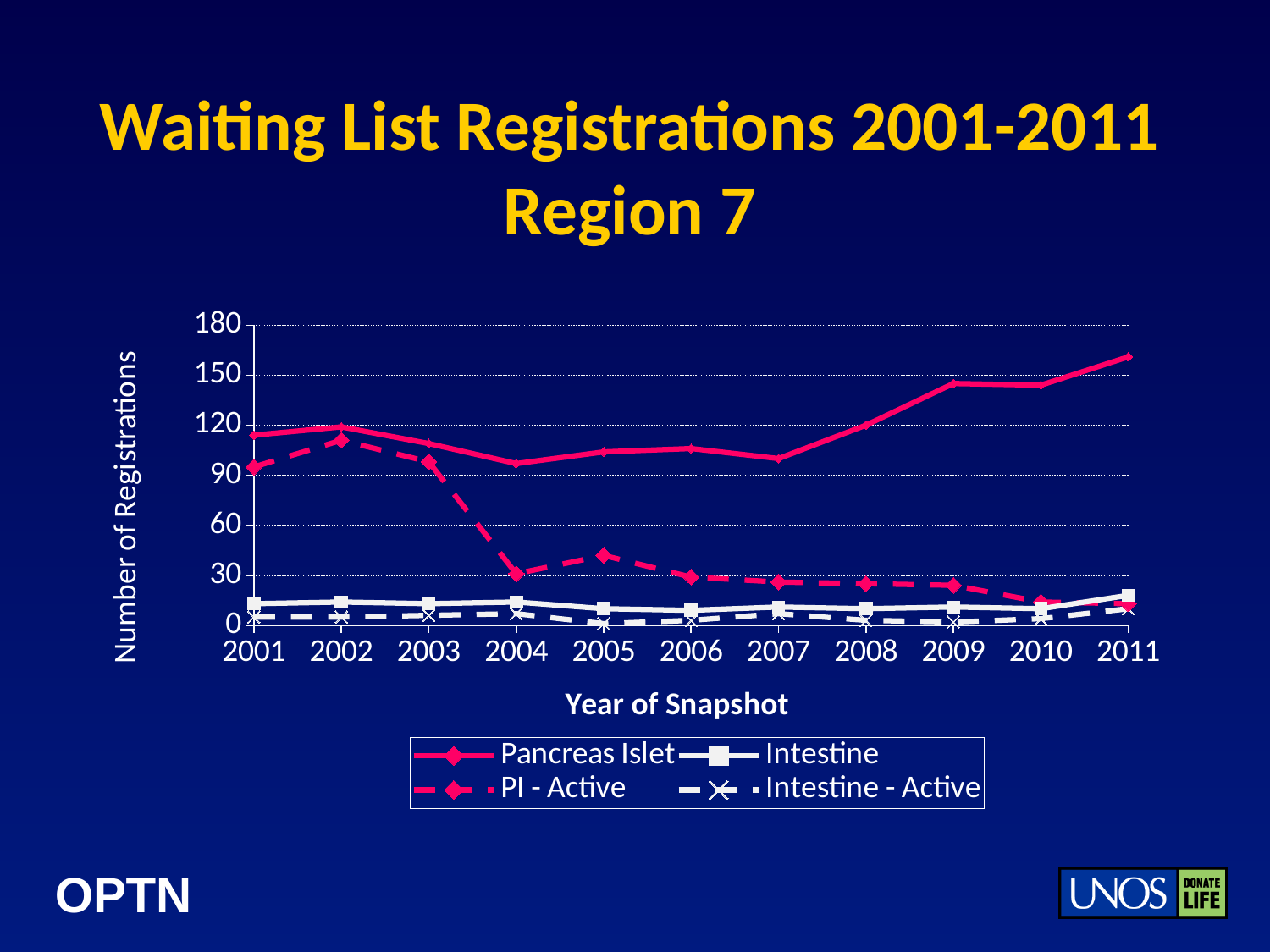
Which is larger in 2004, Pancreas Islet or PI - Active? Pancreas Islet How many years are shown on the x axis? 11 What is the title of the y axis? Number of Registrations Is the value for Pancreas Islet in 2009 greater or less than 120? greater Is the value for Pancreas Islet in 2011 greater or less than 150? greater Is the value for PI - Active in 2004 greater or less than 60? less Does the Pancreas Islet series rise or fall from 2007 to 2011? Rise In which year is the Pancreas Islet series at its highest? 2011 What kind of chart is shown on the slide? Line chart In which year is the Intestine series at its highest? 2011 How many series does the legend list? 4 In which year is the PI - Active series at its highest? 2002